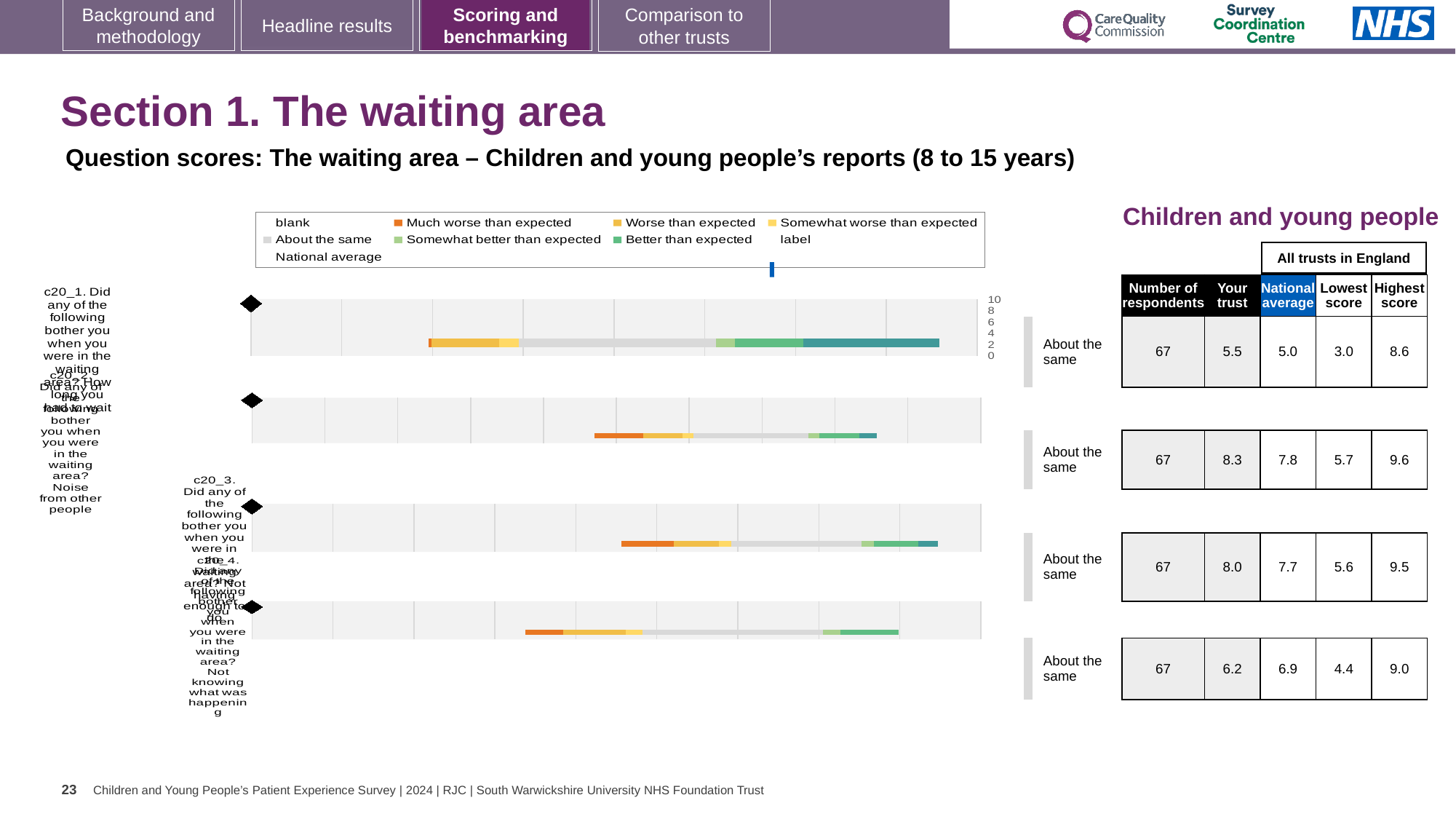
What rating label is printed to the right of the fourth bar chart (c20_4, Not knowing what was happening)? About the same What kind of chart is used to show the question scores on this slide? bar chart What rating label is printed to the right of the first bar chart (c20_1, How long you had to wait)? About the same Which legend entry is shown in orange? Much worse than expected In the table, what is the difference between the Highest score and the Lowest score for c20_1 (How long you had to wait)? 5.6 In the table next to the charts, what is the National average for c20_2 (Noise from other people)? 7.8 In the table next to the charts, how many respondents are listed for c20_4 (Not knowing what was happening)? 67 In the table next to the charts, what is the Highest score for c20_3 (Not having enough to do)? 9.5 How many question bar charts are shown on the slide? 4 What is the highest value shown on the axis of the first bar chart? 10 In the table, which is larger for c20_4 (Not knowing what was happening): the 'Your trust' score or the National average? National average In the table next to the charts, what is the 'Your trust' score for c20_1 (How long you had to wait)? 5.5